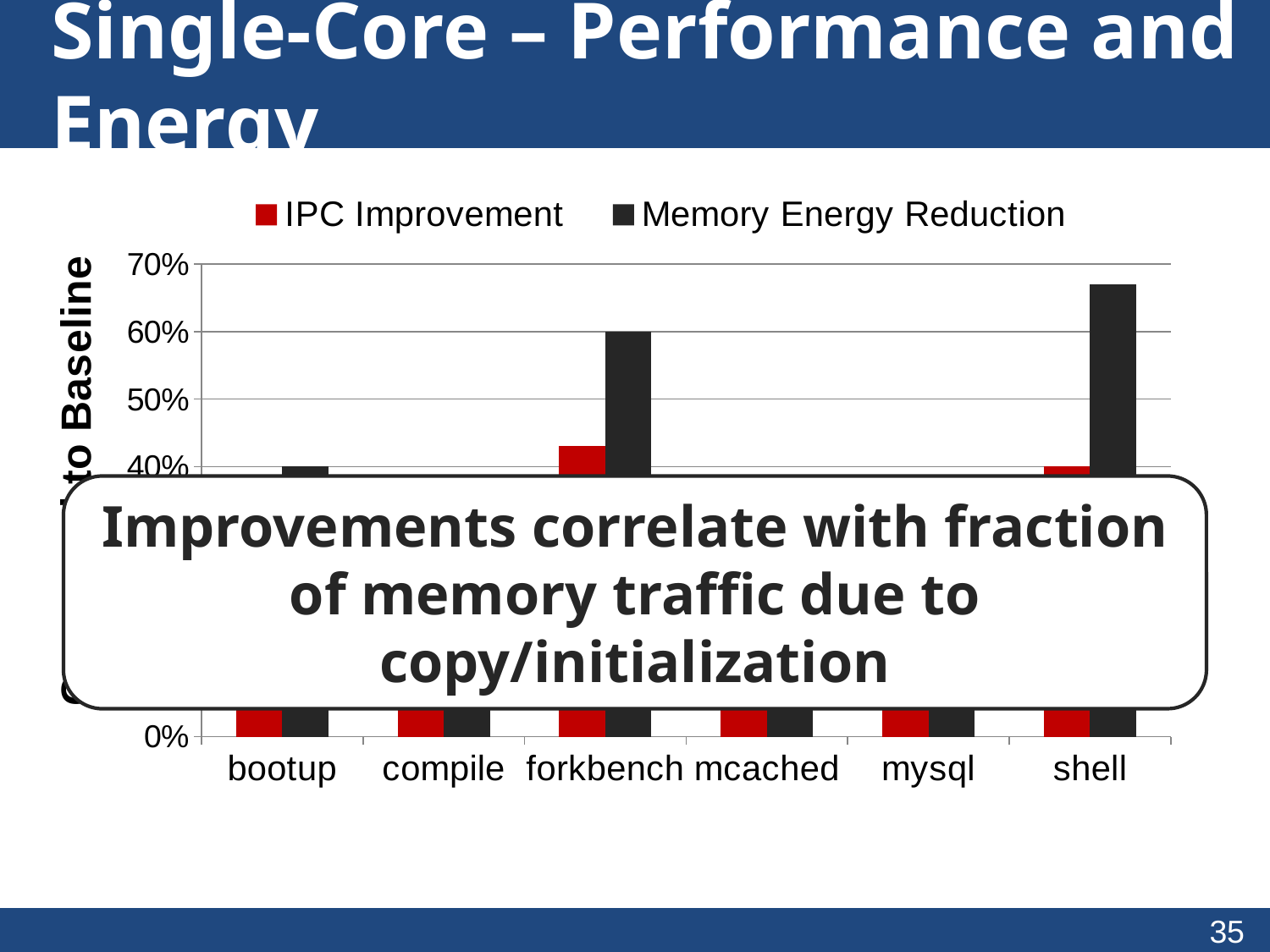
Which series is drawn in red? IPC Improvement How many categories are shown on the x axis? 6 How many series does the legend list? 2 Which is larger: the Memory Energy Reduction for forkbench or for shell? shell Which category has the highest IPC Improvement? forkbench What kind of chart is shown on the slide? bar chart Is the IPC Improvement for bootup greater or less than 40%? less Is the Memory Energy Reduction for shell greater or less than 60%? greater What is the highest value labelled on the y axis? 70% For forkbench, which is larger: IPC Improvement or Memory Energy Reduction? Memory Energy Reduction Is the IPC Improvement for forkbench greater or less than 40%? greater Which category has the highest Memory Energy Reduction? shell